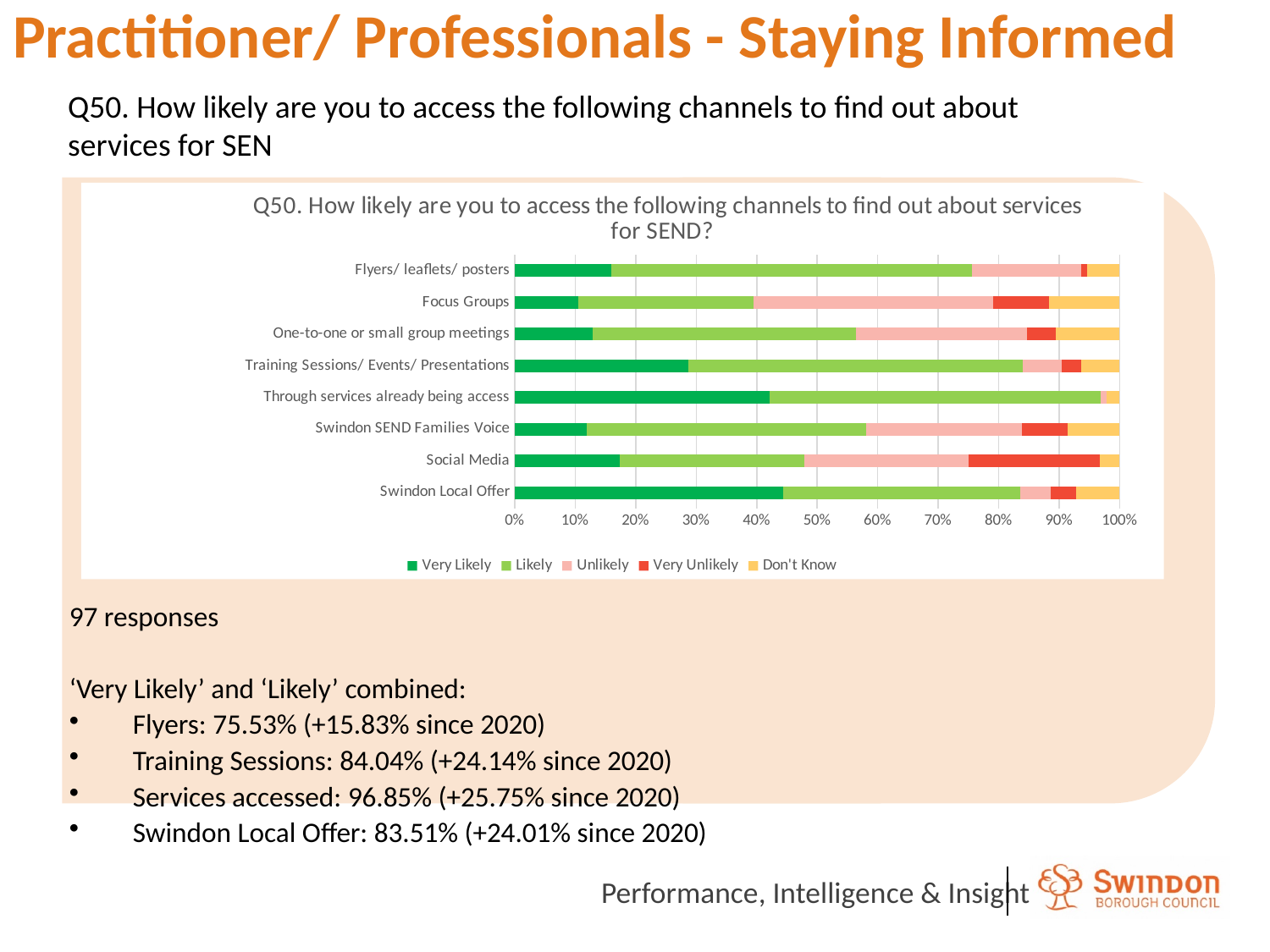
What kind of chart is shown on the slide? Stacked bar chart How many series does the chart legend list? 5 What is the title of the chart? Q50. How likely are you to access the following channels to find out about services for SEND? Is the 'Very Likely' share for Focus Groups greater or less than 20%? less Which channel has the largest 'Very Unlikely' segment? Social Media Which series is shown in dark green in the chart? Very Likely Is the 'Very Likely' share for Training Sessions/ Events/ Presentations greater or less than 20%? greater Is the 'Very Likely' share for Swindon Local Offer greater or less than 30%? greater What value does each stacked bar in the chart total on the x axis? 100% Which has the larger 'Very Unlikely' share: Social Media or Flyers/ leaflets/ posters? Social Media How many channels (categories) are plotted in the chart? 8 Which has the larger 'Very Likely' share: Training Sessions/ Events/ Presentations or Focus Groups? Training Sessions/ Events/ Presentations